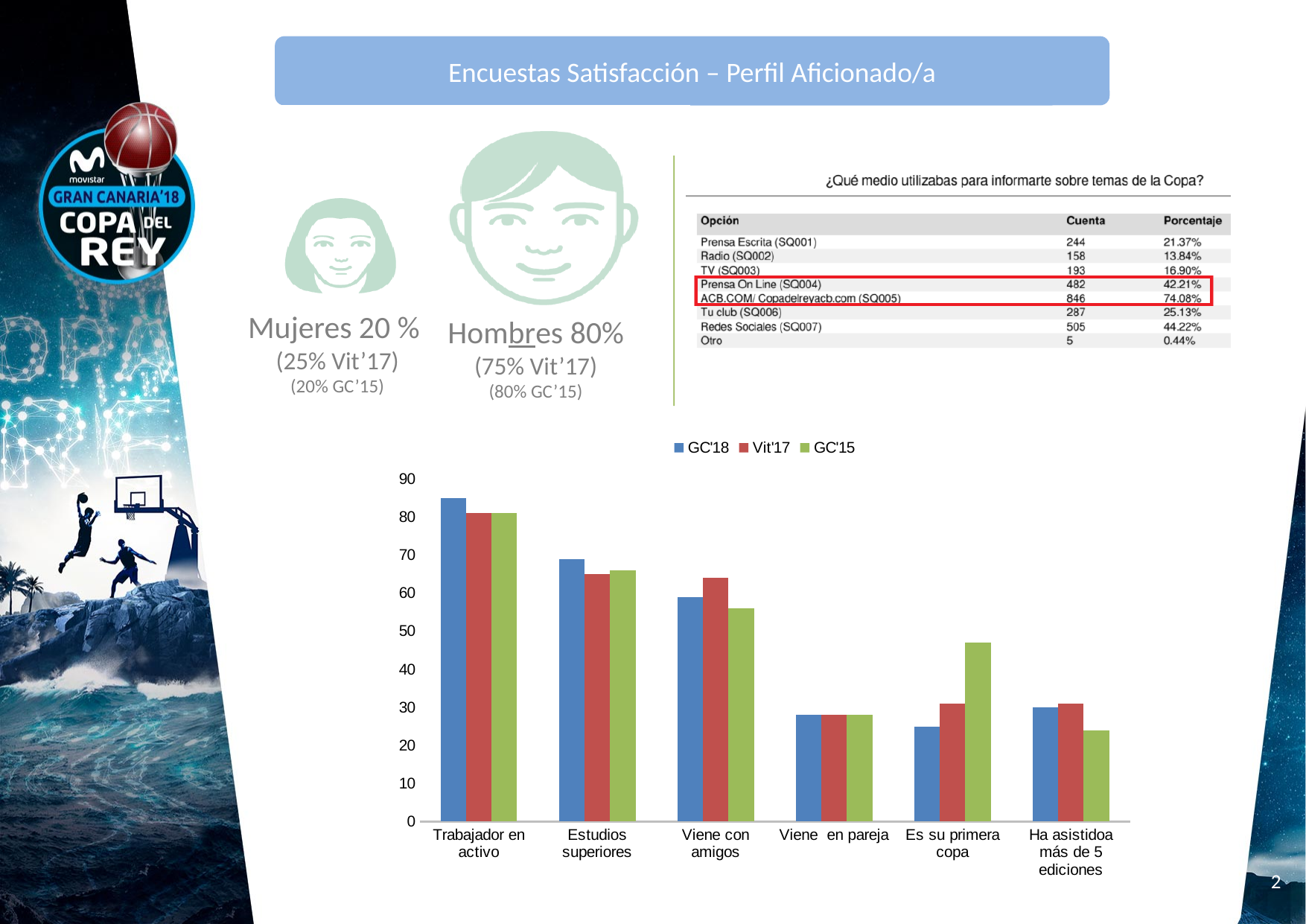
What colour represents the GC'15 series in the chart? green Is the GC'18 value for 'Es su primera copa' greater or less than 30? less In the category 'Es su primera copa', which series has the highest bar? GC'15 What kind of chart is shown on the slide? bar chart Is the Vit'17 value for 'Estudios superiores' greater or less than 70? less How many categories are shown along the x axis of the chart? 6 Which category has the highest GC'18 bar? Trabajador en activo How many series does the chart legend list? 3 In the category 'Viene con amigos', which series has the highest bar? Vit'17 Is the GC'18 value for 'Trabajador en activo' greater or less than 80? greater For 'Ha asistido a más de 5 ediciones', which is larger: the GC'18 value or the GC'15 value? GC'18